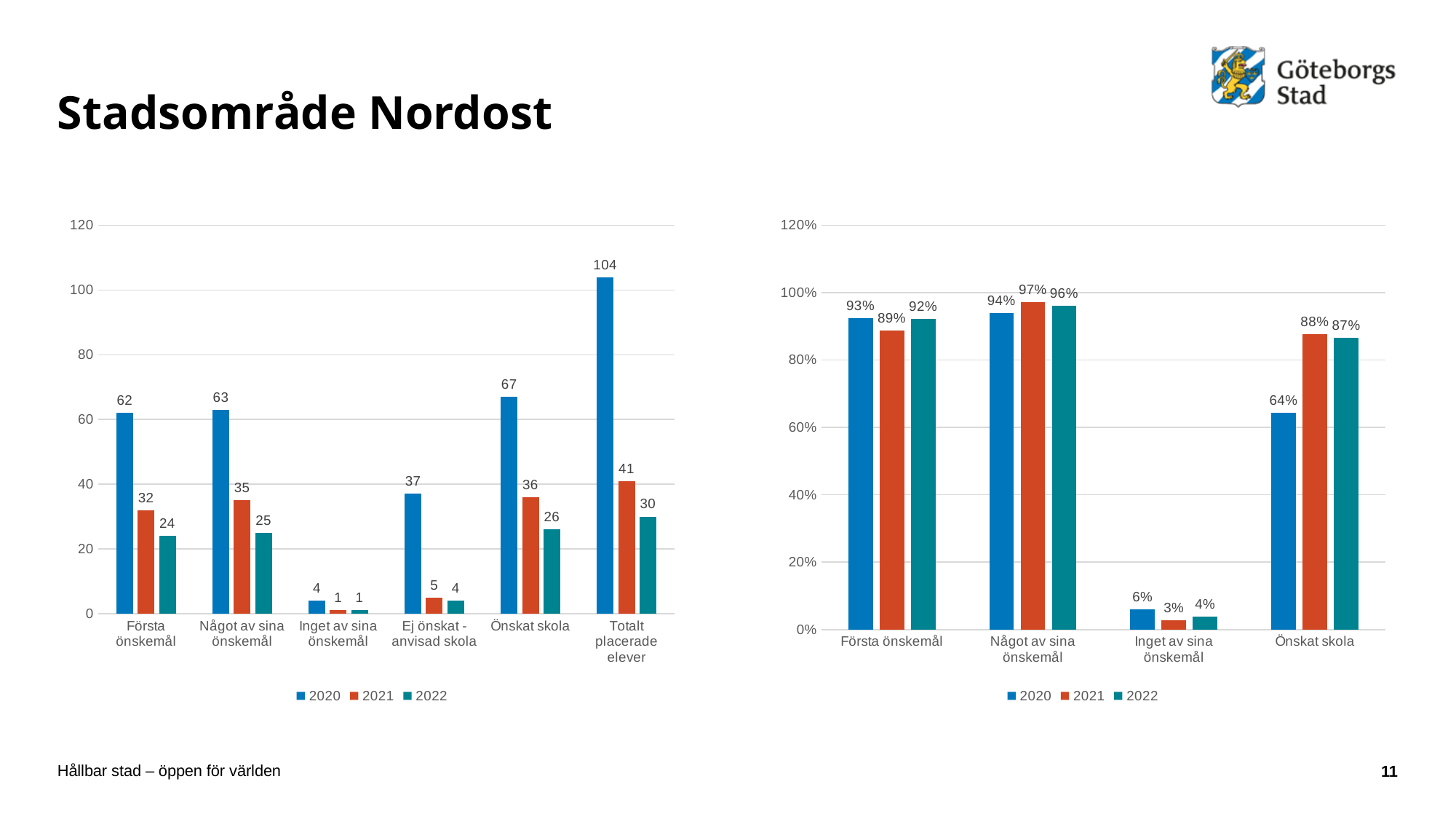
How many series does the legend of the left chart list? 3 In the right chart, which category has the lowest 2022 value? Inget av sina önskemål In the left chart, what is the 2020 value for Totalt placerade elever? 104 In the right chart, what is the difference between the 2021 and 2020 values for Önskat skola? 24% In the left chart, what is the difference between the 2020 and 2021 values for Önskat skola? 31 How many categories are shown on the x axis of the right chart? 4 In the left chart, which is larger for Ej önskat - anvisad skola: the 2020 value or the 2021 value? 2020 In the right chart, what is the 2020 value for Inget av sina önskemål? 6% What type of chart is the left chart? Bar chart In the right chart, what is the 2021 value for Önskat skola? 88% In the left chart, what is the 2022 value for Första önskemål? 24 In the left chart, which category has the highest 2020 value? Totalt placerade elever